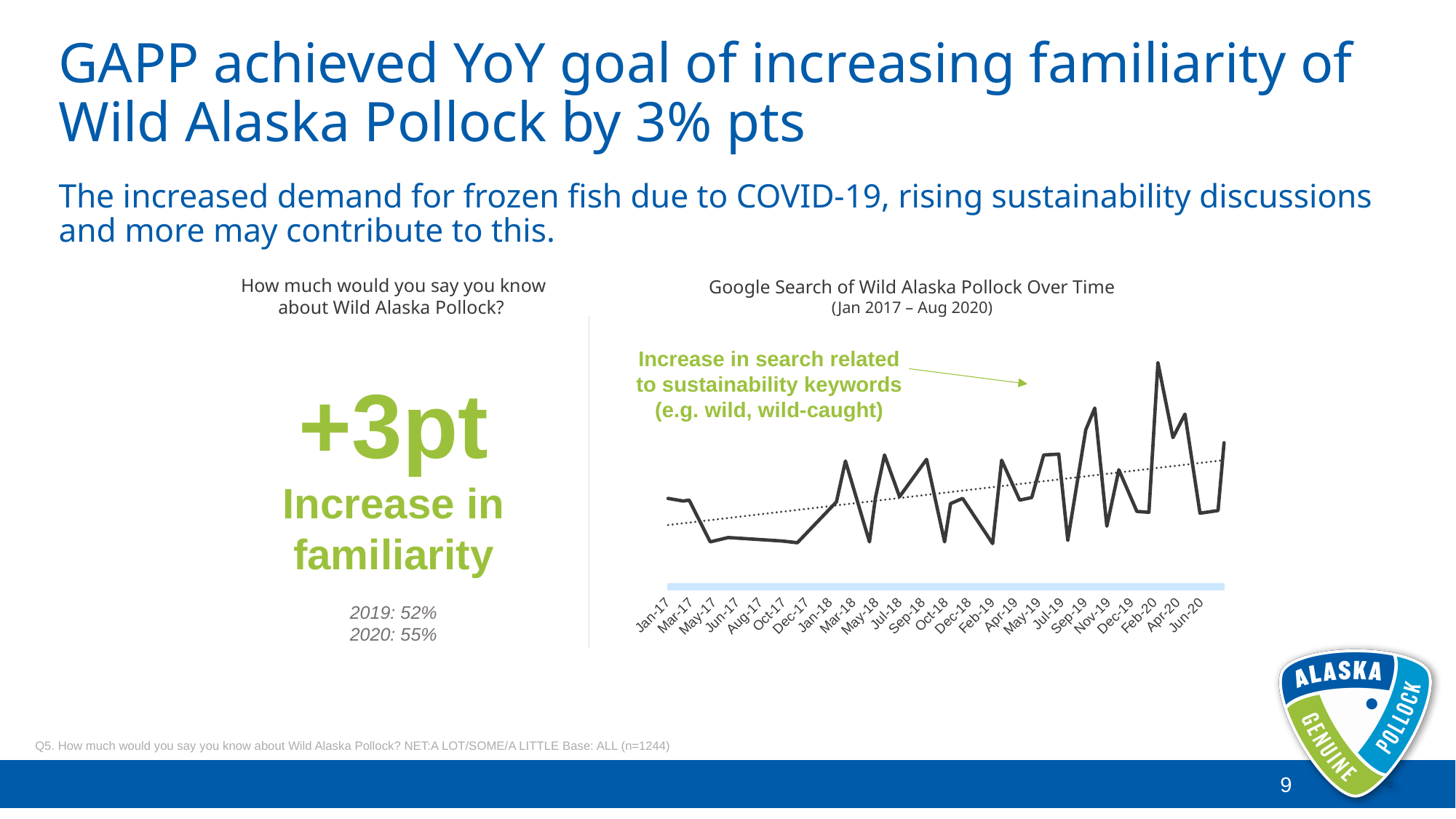
In the 'Google Search of Wild Alaska Pollock Over Time' chart, is the overall direction of search interest from Jan-17 to Jun-20 increasing or decreasing? increasing In the 'Google Search of Wild Alaska Pollock Over Time' chart, does the dotted trend line rise or fall from left to right? rise What is the first label on the x axis of the 'Google Search of Wild Alaska Pollock Over Time' chart? Jan-17 What is the last label on the x axis of the 'Google Search of Wild Alaska Pollock Over Time' chart? Jun-20 What time period does the 'Google Search of Wild Alaska Pollock Over Time' chart cover, according to its subtitle? Jan 2017 – Aug 2020 What does the green annotation on the 'Google Search of Wild Alaska Pollock Over Time' chart attribute the increase in search to? sustainability keywords (e.g. wild, wild-caught) What kind of chart is the 'Google Search of Wild Alaska Pollock Over Time' chart? line chart